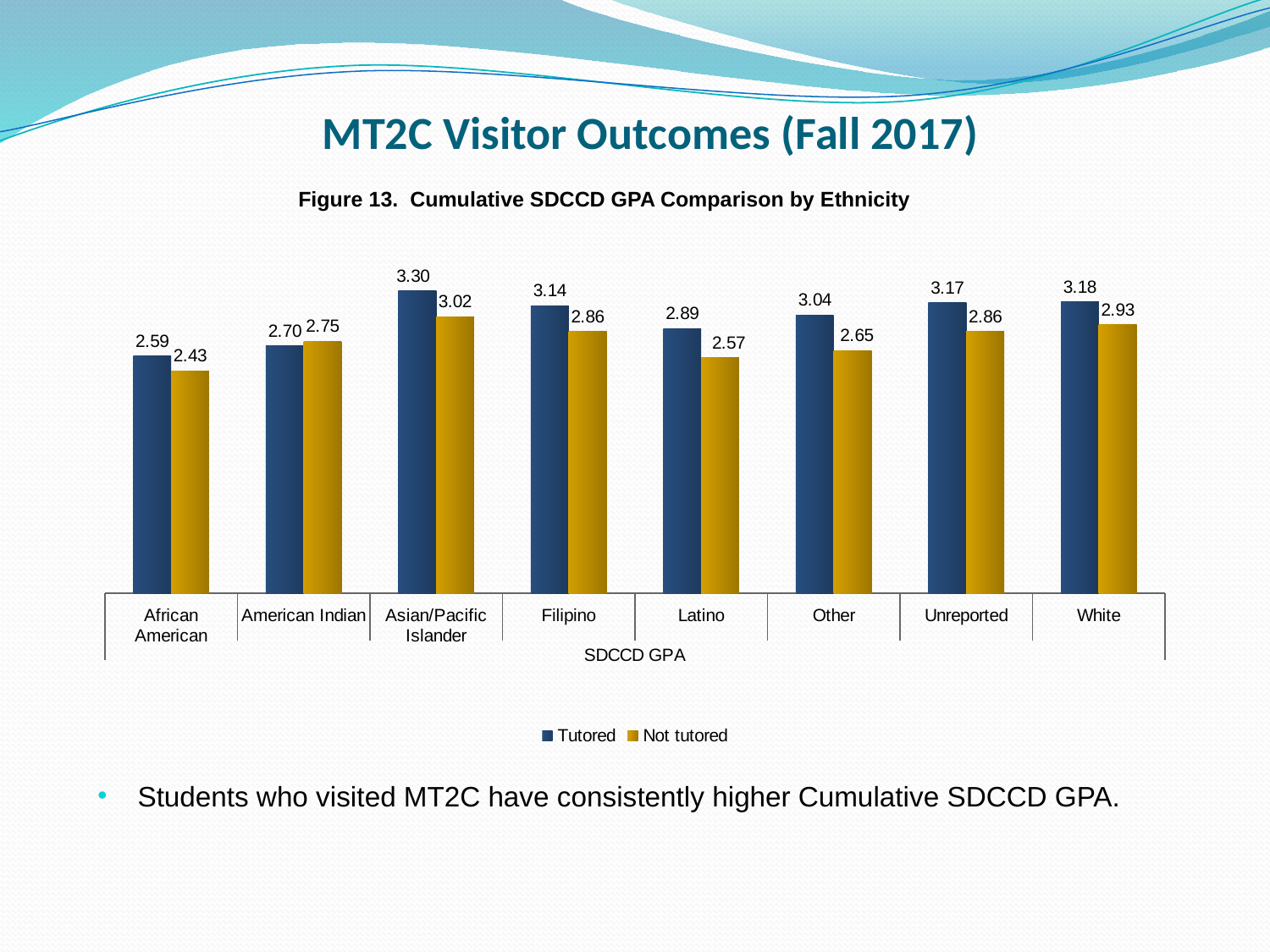
Which ethnicity has the highest Tutored cumulative GPA? Asian/Pacific Islander What is the Tutored cumulative GPA for African American students? 2.59 How many series does the legend list? 2 Which colour represents the Not tutored series? Gold How many ethnicity categories are shown on the x axis? 8 What is the difference between the Tutored and Not tutored GPA for Other students? 0.39 Which is larger for American Indian students, the Tutored GPA or the Not tutored GPA? Not tutored What kind of chart is shown on the slide? Bar chart What is the Not tutored cumulative GPA for Latino students? 2.57 Which ethnicity has the lowest Not tutored cumulative GPA? African American What is the title of the figure shown on the slide? Figure 13. Cumulative SDCCD GPA Comparison by Ethnicity What is the Tutored cumulative GPA for Asian/Pacific Islander students? 3.30